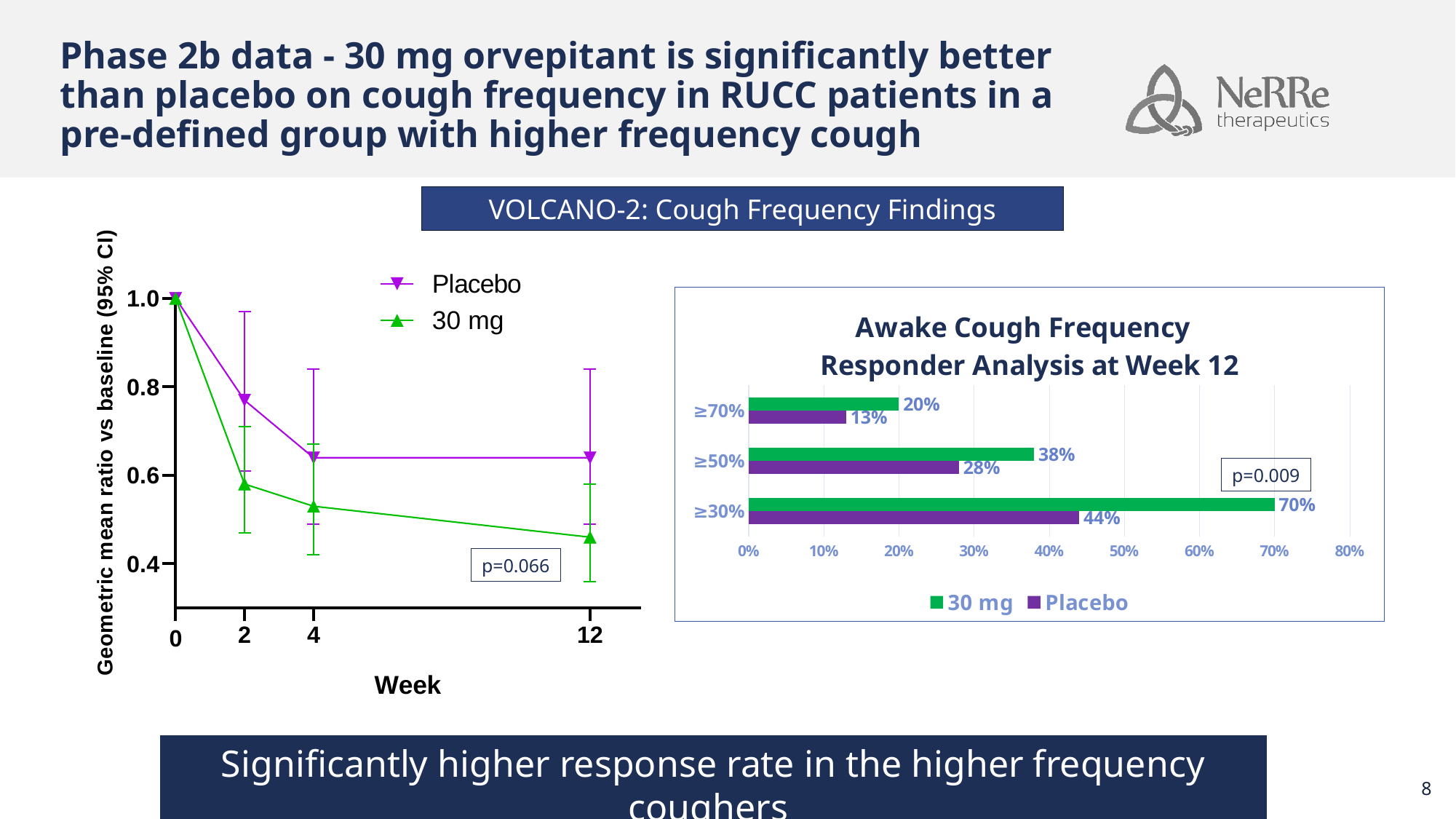
In the Awake Cough Frequency Responder Analysis chart, what is the difference between 30 mg and Placebo at the ≥50% threshold? 10% In the Awake Cough Frequency Responder Analysis chart, what is the difference between 30 mg and Placebo at the ≥30% threshold? 26% In the Awake Cough Frequency Responder Analysis chart, what is the value for 30 mg at the ≥30% threshold? 70% In the Awake Cough Frequency Responder Analysis chart, what is the value for Placebo at the ≥70% threshold? 13% In the line chart on the left, is the value for 30 mg at week 12 greater or less than 0.6? less In the Awake Cough Frequency Responder Analysis chart, how many series does the legend list? 2 In the Awake Cough Frequency Responder Analysis chart, which series has the higher value at the ≥70% threshold, 30 mg or Placebo? 30 mg In the line chart on the left, is the value for Placebo at week 12 greater or less than 0.6? greater In the line chart on the left, does the 30 mg series rise or fall from week 0 to week 12? Fall What kind of chart is the Awake Cough Frequency Responder Analysis chart? Bar chart In the Awake Cough Frequency Responder Analysis chart, what is the value for Placebo at the ≥50% threshold? 28% In the Awake Cough Frequency Responder Analysis chart, which response threshold has the highest value for 30 mg? ≥30%